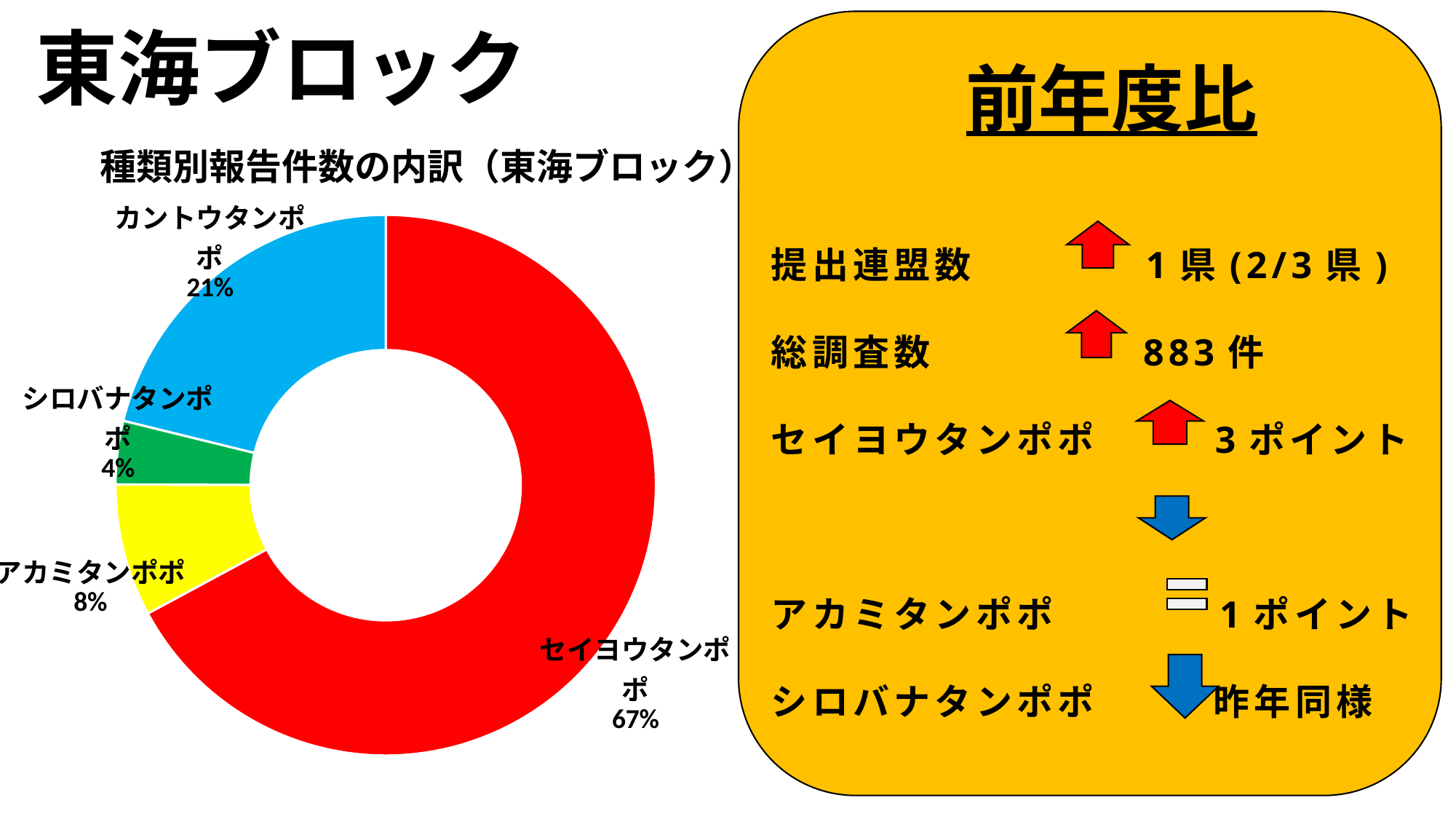
Which has a larger share, アカミタンポポ or シロバナタンポポ? アカミタンポポ What share of the chart does アカミタンポポ account for? 8% What colour is the セイヨウタンポポ slice? Red How many categories are shown in the chart? 4 What share of the chart does シロバナタンポポ account for? 4% Which category has the smallest share in the chart? シロバナタンポポ What kind of chart is shown on the slide? Doughnut (pie) chart Which category has the largest share in the chart? セイヨウタンポポ What is the title of the chart? 種類別報告件数の内訳（東海ブロック） What share of the chart does セイヨウタンポポ account for? 67% What is the difference in percentage points between セイヨウタンポポ and カントウタンポポ? 46 percentage points What share of the chart does カントウタンポポ account for? 21%